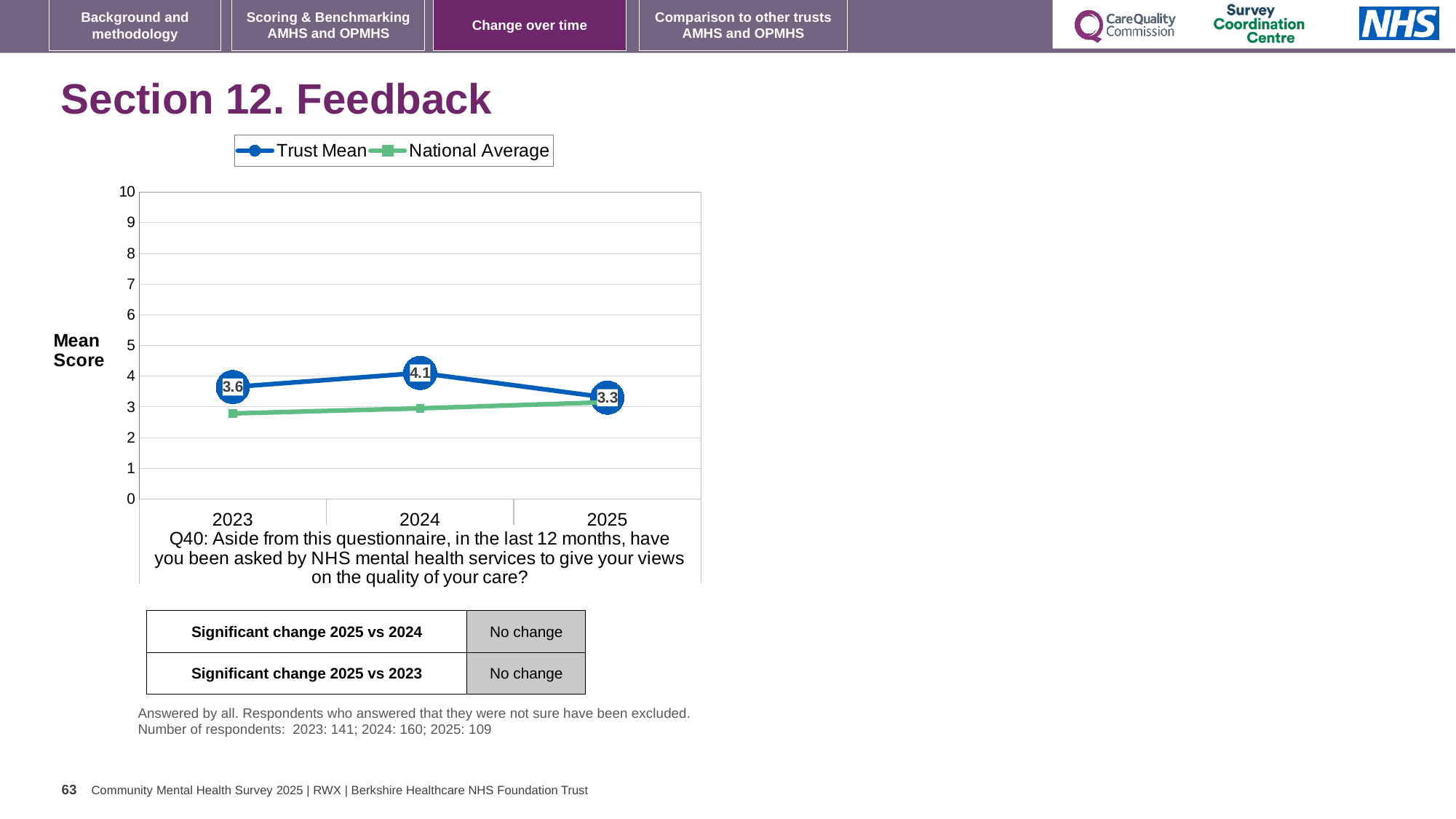
Does the National Average rise or fall from 2023 to 2025? rise In which year is the Trust Mean highest? 2024 Which is larger in 2024, the Trust Mean or the National Average? Trust Mean How many series does the legend list? 2 What is the Trust Mean value for 2024? 4.1 Is the National Average value for 2023 greater or less than 3? less How many years are shown on the x axis? 3 What is the Trust Mean value for 2023? 3.6 In which year is the Trust Mean lowest? 2025 What is the difference between the Trust Mean in 2024 and in 2025? 0.8 What kind of chart is shown on the slide? line chart What is the Trust Mean value for 2025? 3.3